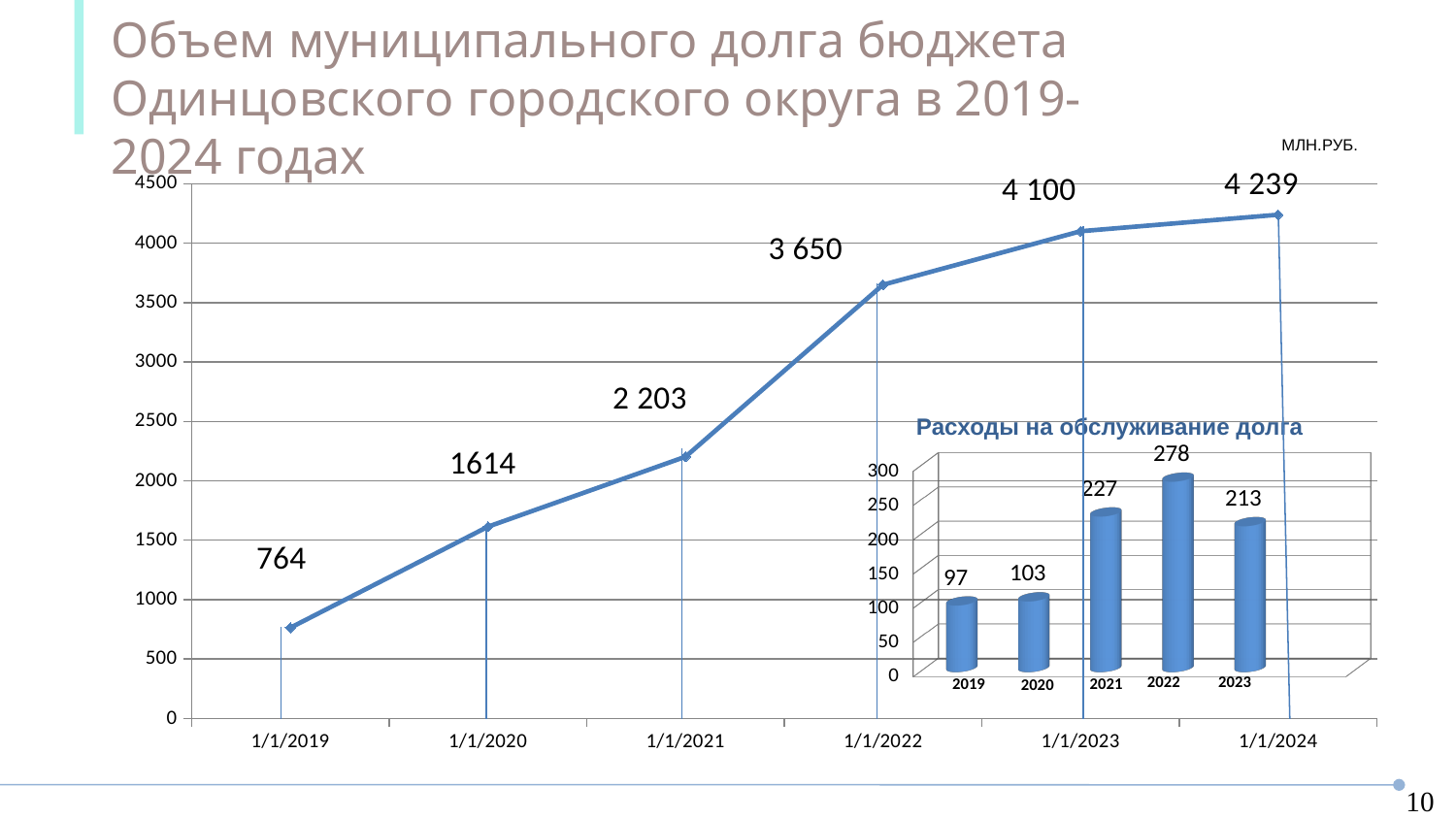
On the line chart of municipal debt volume, what is the value for 1/1/2019? 764 On the line chart of municipal debt volume, how many data points are plotted? 6 What type of chart is the inset chart 'Расходы на обслуживание долга'? bar chart On the inset chart 'Расходы на обслуживание долга', which year has the lowest value? 2019 On the inset chart 'Расходы на обслуживание долга', which is larger, the value for 2021 or the value for 2023? 2021 On the line chart of municipal debt volume, is the value for 1/1/2021 greater or less than 2000? greater On the line chart of municipal debt volume, what is the value for 1/1/2022? 3 650 On the line chart of municipal debt volume, what is the difference between the values for 1/1/2024 and 1/1/2023? 139 On the line chart of municipal debt volume, which date has the highest value? 1/1/2024 On the line chart of municipal debt volume, do the values rise or fall from 1/1/2019 to 1/1/2024? rise On the inset chart 'Расходы на обслуживание долга', what is the value for 2022? 278 On the inset chart 'Расходы на обслуживание долга', what is the difference between the values for 2022 and 2023? 65